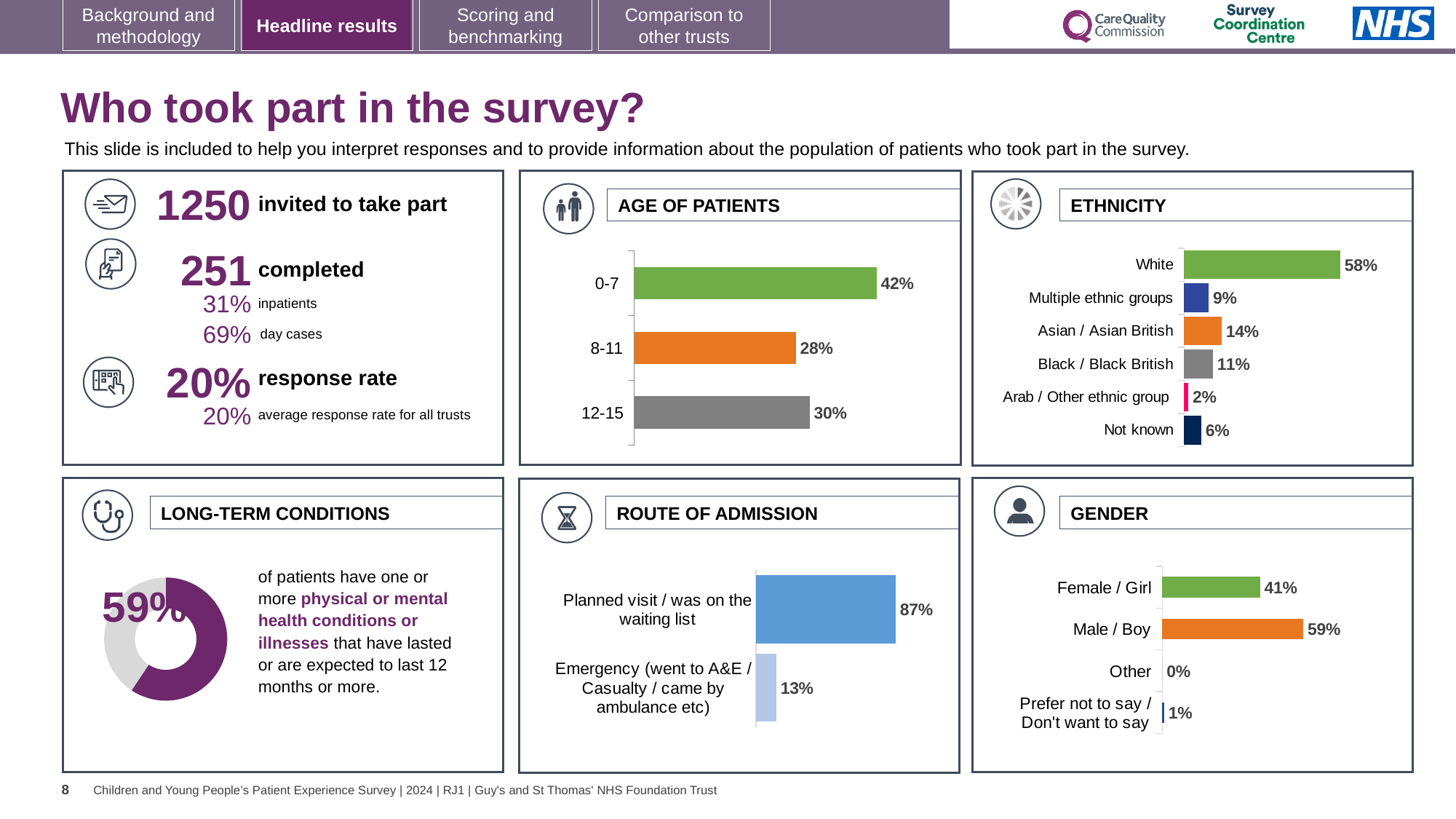
In the ROUTE OF ADMISSION chart, what is the difference between the Planned visit and Emergency percentages? 74% In the AGE OF PATIENTS chart, what is the difference between the 0-7 and 12-15 percentages? 12% In the ETHNICITY chart, which is larger: Multiple ethnic groups or Black / Black British? Black / Black British In the AGE OF PATIENTS chart, what percentage of patients are aged 0-7? 42% In the ETHNICITY chart, what percentage of patients are Asian / Asian British? 14% In the GENDER chart, what percentage of patients are Male / Boy? 59% In the AGE OF PATIENTS chart, which age group has the lowest percentage? 8-11 What kind of chart is used in the LONG-TERM CONDITIONS panel? Donut chart How many categories are shown in the ETHNICITY chart? 6 In the GENDER chart, which category has the lowest percentage? Other In the ETHNICITY chart, which category has the highest percentage? White In the ROUTE OF ADMISSION chart, what percentage of patients came via Emergency (went to A&E / Casualty / came by ambulance etc)? 13%